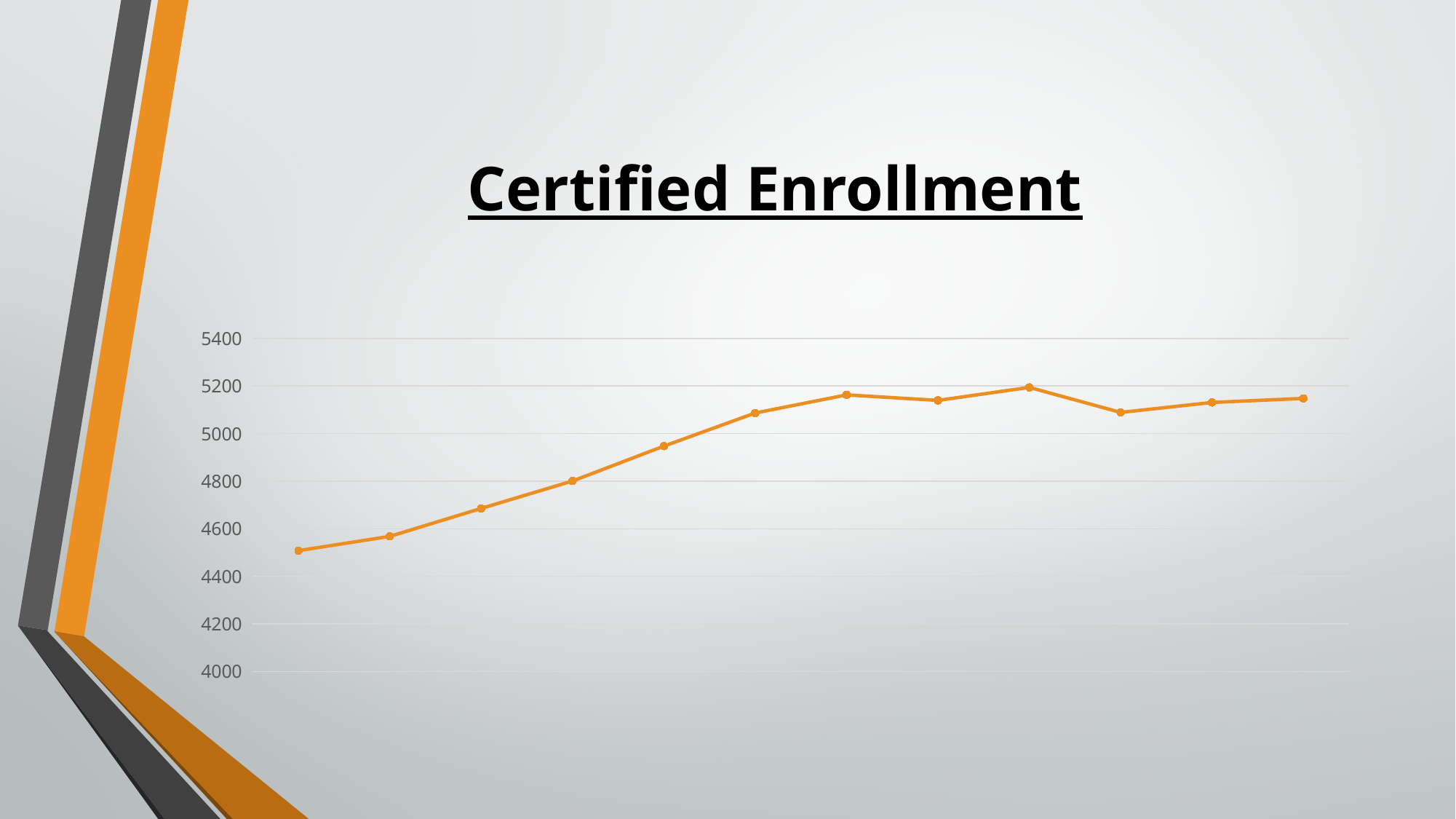
What is the title of the chart? Certified Enrollment Is the value of the fourth point from the left greater or less than 5000? less How many data points are plotted on the line? 12 Is the value of the fifth point from the left greater or less than 4800? greater Is the value of the leftmost (first) point greater or less than 4600? less Which is larger, the value of the third point from the left or the value of the sixth point from the left? the sixth point Do the values generally rise or fall from left to right along the x axis? rise Which point has the lowest value, the first point or the last point? the first point What kind of chart is shown on the slide? line chart What is the highest value shown on the vertical axis? 5400